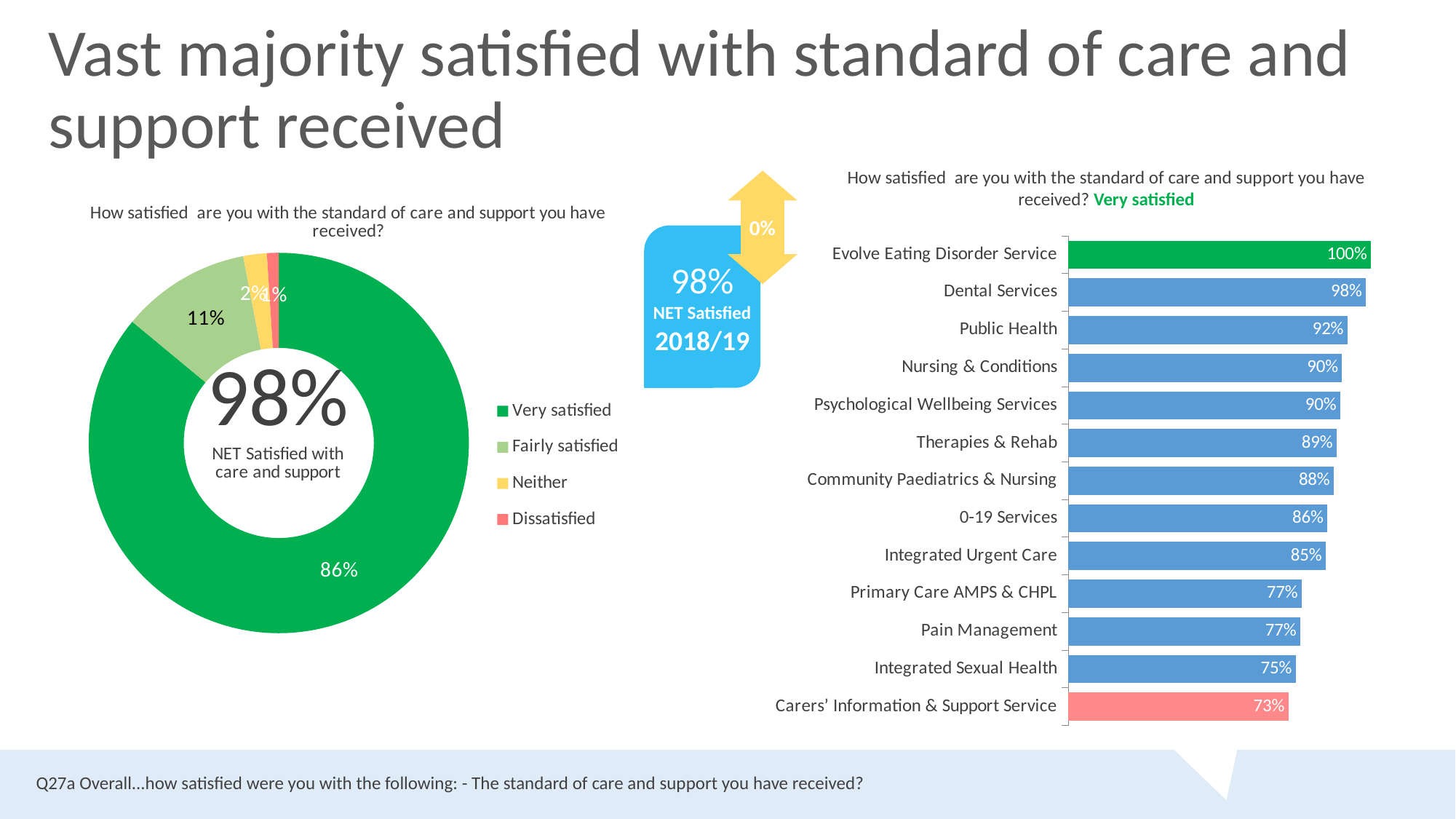
In the donut chart on the left, what share of respondents are Very satisfied? 86% In the bar chart on the right, what colour is the bar for Carers' Information & Support Service? Red In the bar chart on the right, which service has the highest value? Evolve Eating Disorder Service How many services are shown in the bar chart on the right? 13 In the bar chart on the right, which is larger: 0-19 Services or Integrated Urgent Care? 0-19 Services How many entries does the legend of the donut chart on the left list? 4 In the donut chart on the left, what is the difference between Very satisfied and Fairly satisfied? 75% What type of chart is the chart on the right? Bar chart In the bar chart on the right, what is the difference between Public Health and Integrated Sexual Health? 17% In the bar chart on the right, what is the value for Dental Services? 98% In the donut chart on the left, what is the value for Fairly satisfied? 11% In the bar chart on the right, which service has the lowest value? Carers' Information & Support Service